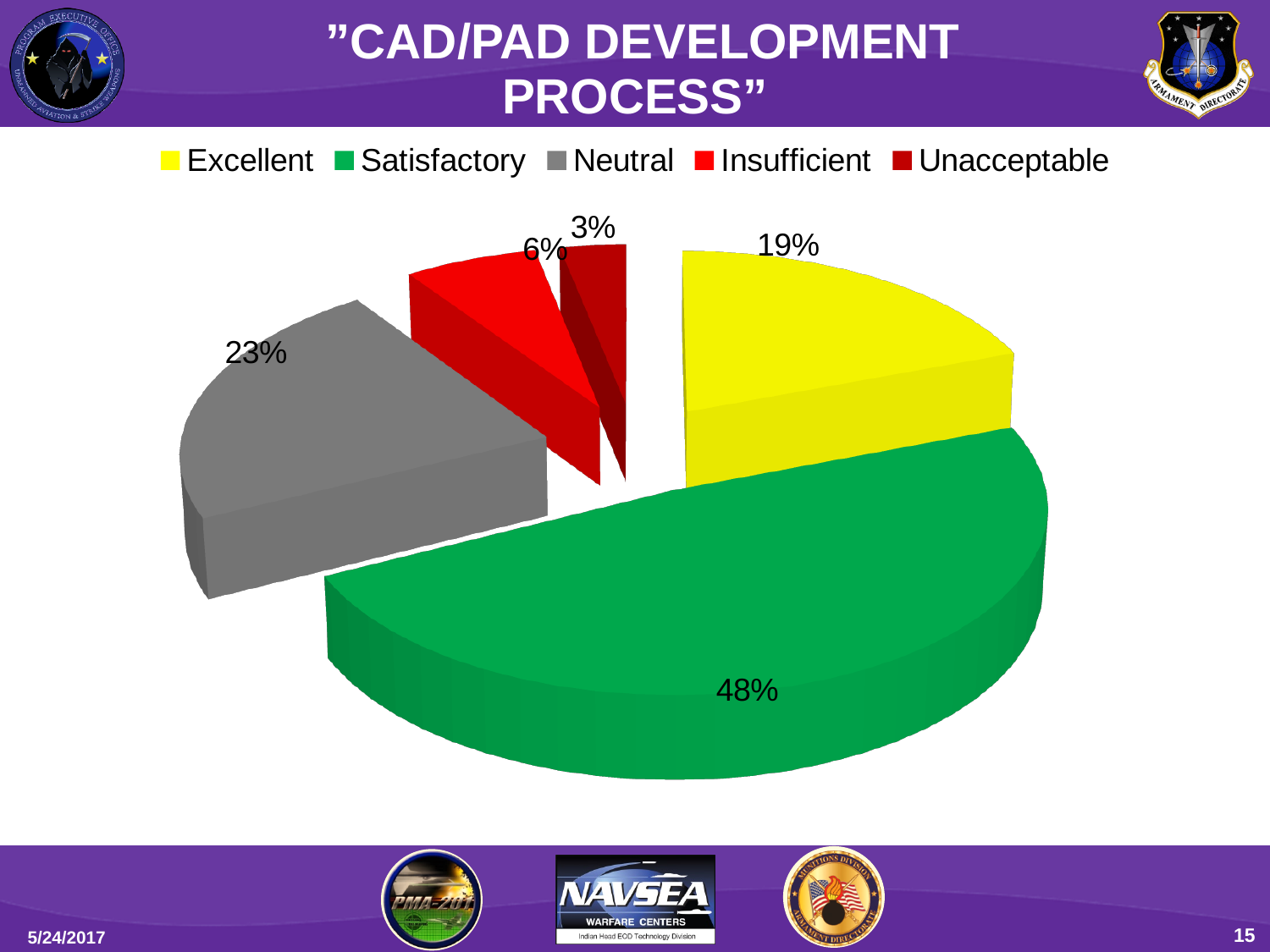
What share of the pie does Insufficient represent? 6% What colour is the Excellent slice? yellow What share of the pie does Neutral represent? 23% What kind of chart is shown on the slide? pie chart What is the difference in percentage points between Satisfactory and Neutral? 25 What share of the pie does Satisfactory represent? 48% Which category has the smallest slice of the pie? Unacceptable How many categories does the legend list? 5 Which category has the largest slice of the pie? Satisfactory Which is larger, the share for Excellent or the share for Neutral? Neutral